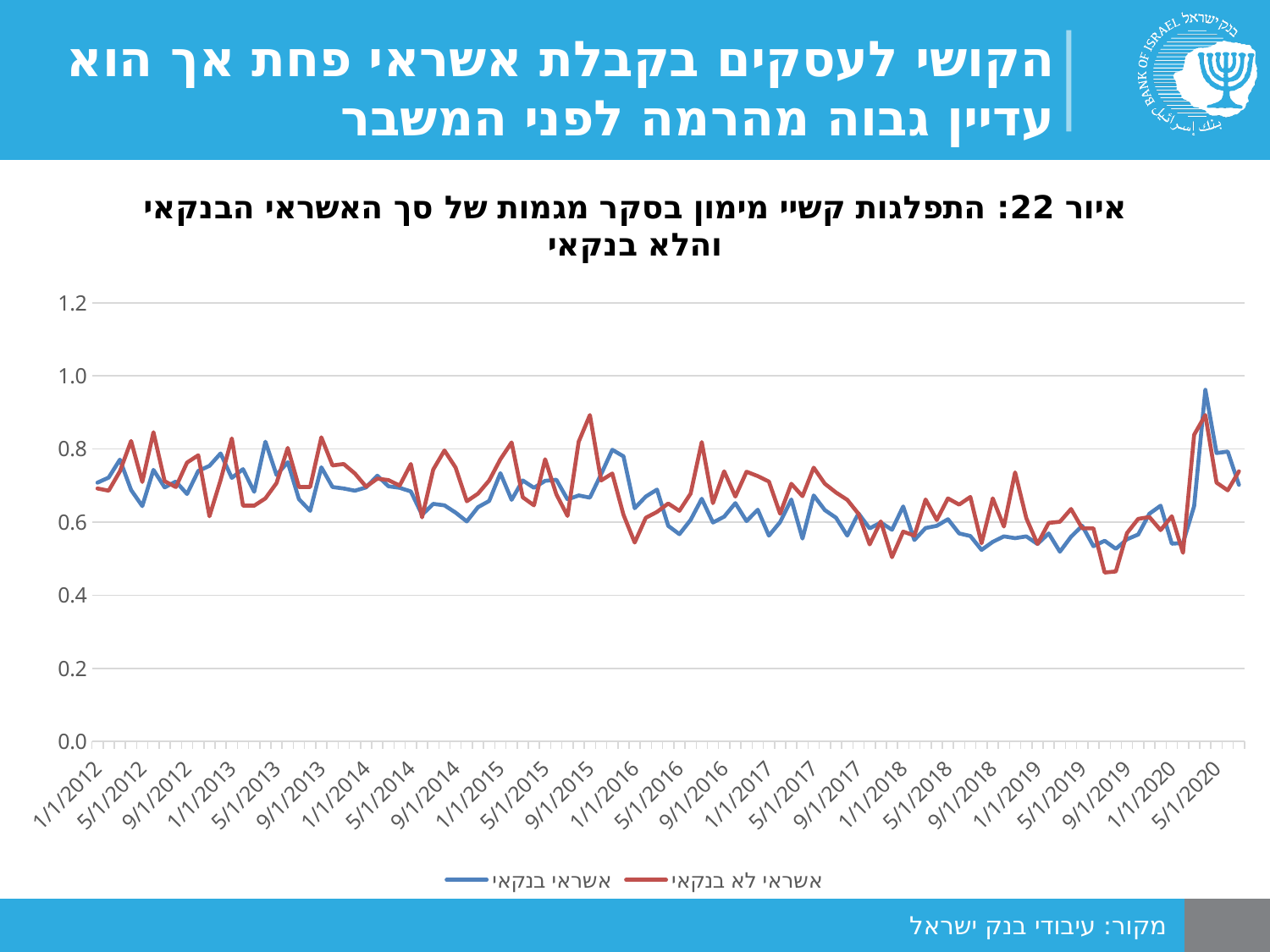
How many series does the legend list? 2 What kind of chart is shown on the slide? line chart Is the peak of the אשראי לא בנקאי line around 9/1/2015 greater or less than 0.8? greater Is the value of the אשראי לא בנקאי line at 1/1/2016 greater or less than 0.6? less Is the lowest value of the אשראי לא בנקאי line, reached around 9/1/2019, greater or less than 0.6? less What is the first date label on the horizontal axis? 1/1/2012 Which colour is used for the series אשראי בנקאי? blue Do the values of the אשראי בנקאי line generally rise or fall between 2012 and 2019? fall Which series reaches the higher peak in 2020, אשראי בנקאי or אשראי לא בנקאי? אשראי בנקאי What is the highest value shown on the vertical axis? 1.2